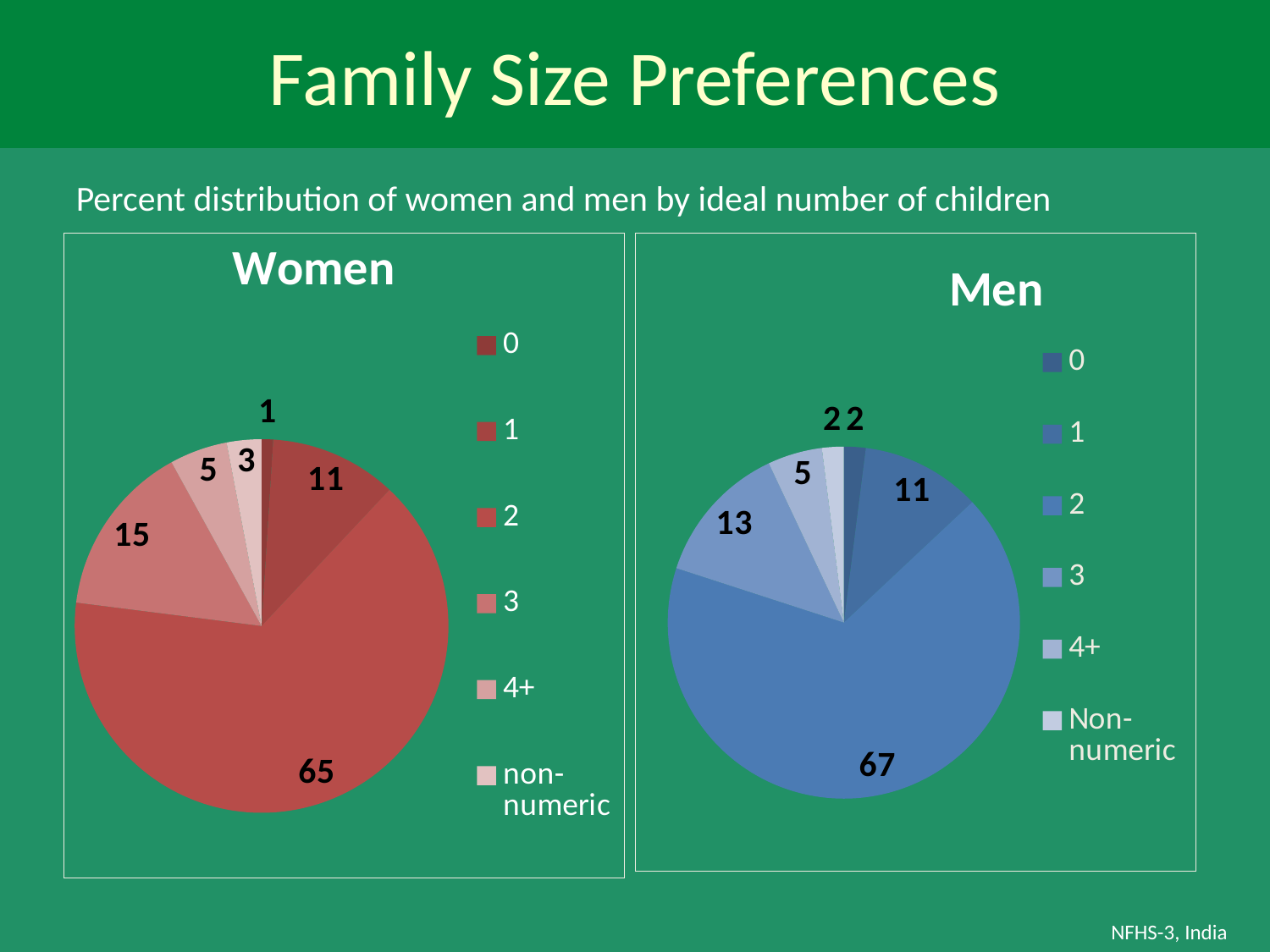
In the Women pie chart, what percentage of women say 2 is the ideal number of children? 65 In the Women pie chart, what is the value for the 4+ category? 5 What is the difference between the value for 2 children in the Men chart and the value for 2 children in the Women chart? 2 How many categories does the Men pie chart show? 6 What is the title of the chart on the right side of the slide? Men In the Men pie chart, what is the value for the 3 children category? 13 In the Women pie chart, which category has the smallest slice? 0 Which is larger: the value for 3 children in the Women chart or the value for 3 children in the Men chart? Women In the Women pie chart, what is the value for the 3 children category? 15 In the Men pie chart, what percentage of men say 2 is the ideal number of children? 67 In the Women pie chart, which category has the largest slice? 2 What type of chart is used for the Women data? Pie chart